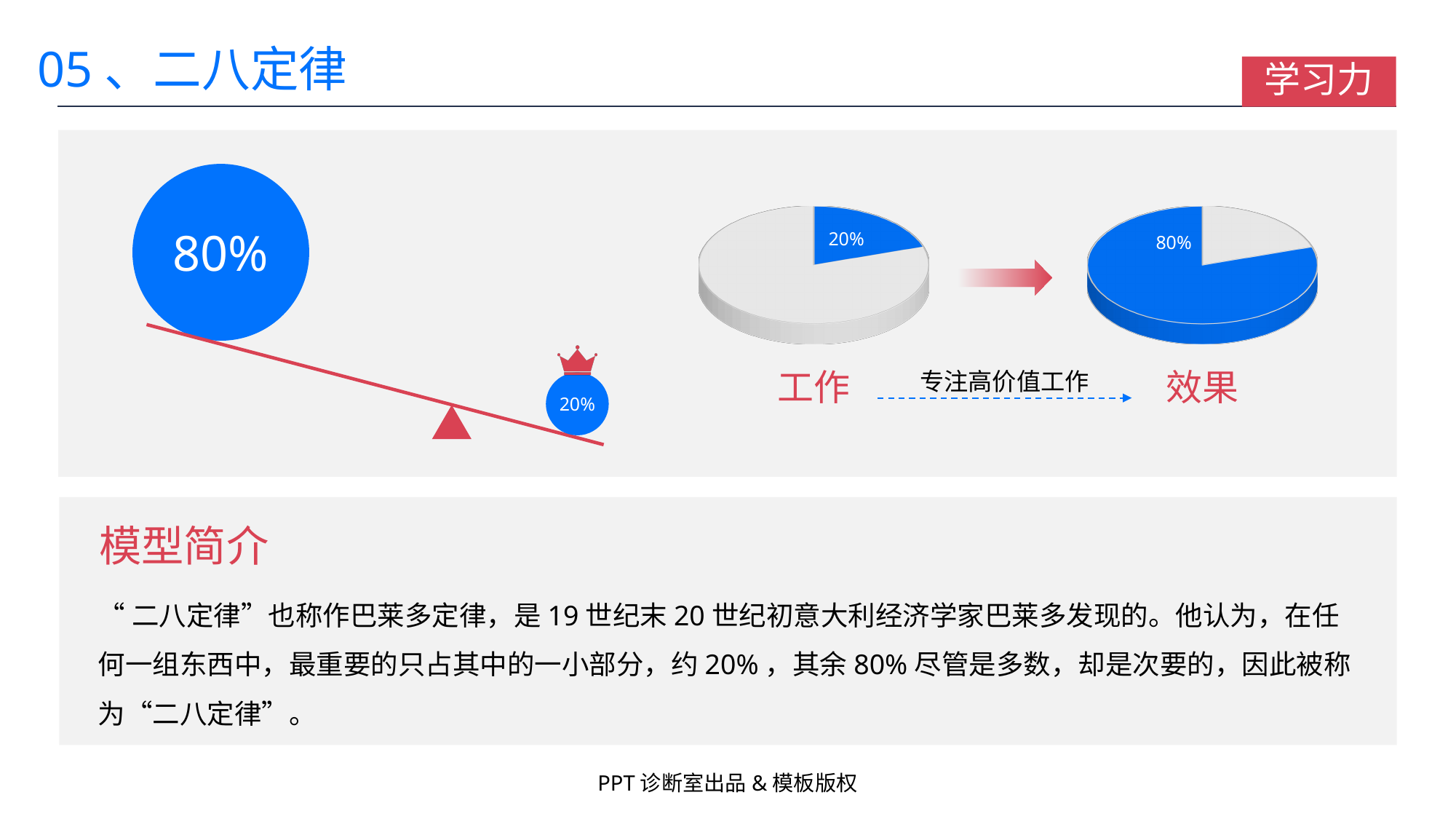
What kind of chart is the chart labelled 效果 on the right? pie chart How many slices does the pie chart labelled 效果 have? 2 What text is written on the dashed arrow between the two pie chart labels? 专注高价值工作 What share of the pie chart labelled 工作 does the blue slice represent? 20% What kind of chart is the chart labelled 工作 on the left? pie chart In the pie chart labelled 工作, what value is printed on the blue slice? 20% Which pie chart has the larger blue slice, the one labelled 工作 or the one labelled 效果? 效果 How many pie charts are shown on the slide? 2 In the pie chart labelled 效果, what value is printed on the blue slice? 80% How many slices does the pie chart labelled 工作 have? 2 What is the difference between the blue slice of the 效果 pie chart (80%) and the blue slice of the 工作 pie chart (20%)? 60% What label is printed below the left pie chart? 工作